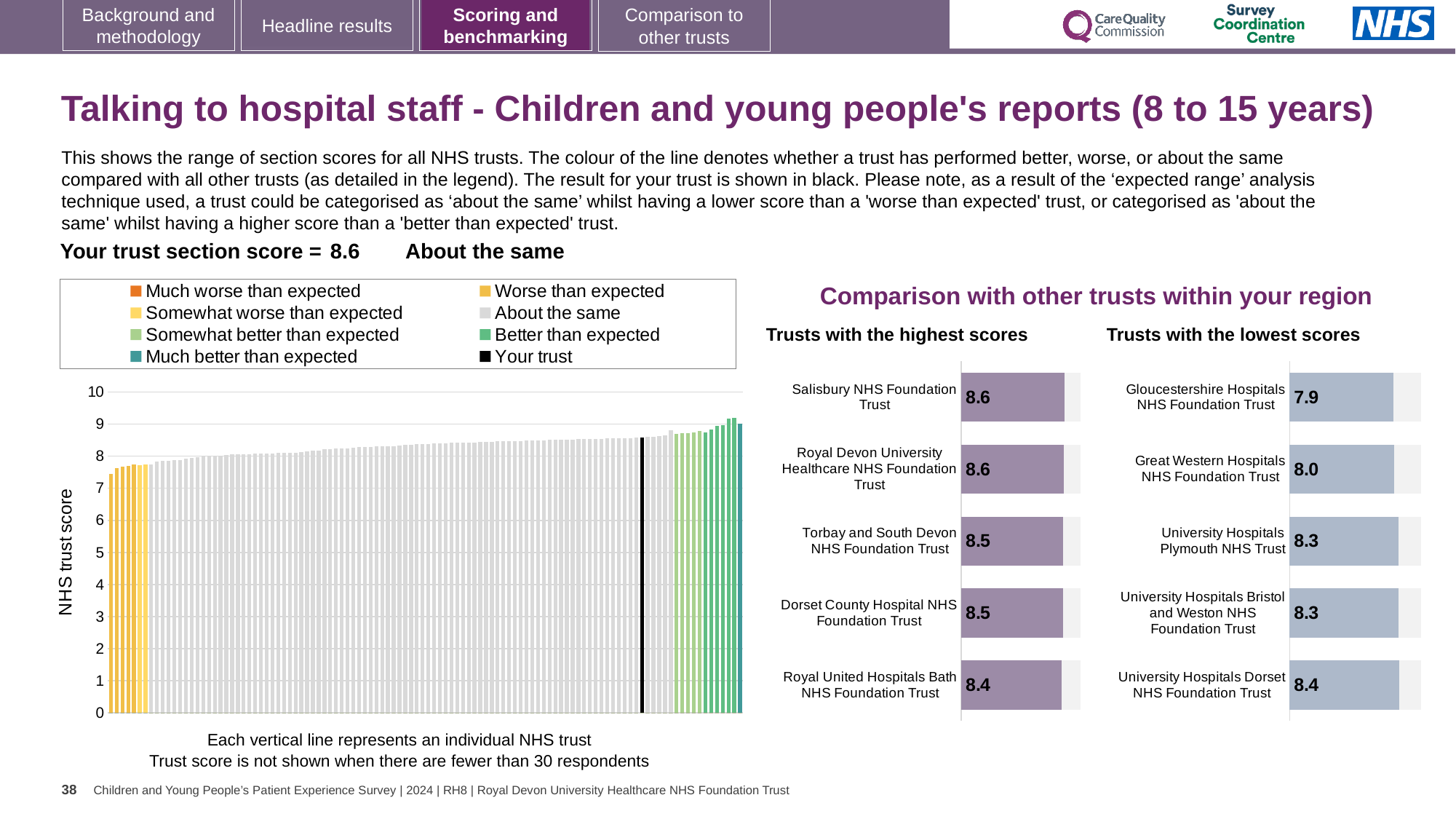
In the 'Trusts with the highest scores' chart, what is the value for Torbay and South Devon NHS Foundation Trust? 8.5 In the 'Trusts with the lowest scores' chart, which is larger: the value for Great Western Hospitals NHS Foundation Trust or University Hospitals Plymouth NHS Trust? University Hospitals Plymouth NHS Trust In the large chart on the left, do the trust scores rise or fall from left to right along the x axis? rise In the 'Trusts with the highest scores' chart, what is the difference between the values for Salisbury NHS Foundation Trust and Royal United Hospitals Bath NHS Foundation Trust? 0.2 In the 'Trusts with the highest scores' chart, what is the value for Royal United Hospitals Bath NHS Foundation Trust? 8.4 What kind of chart is the large chart on the left with the y axis labelled 'NHS trust score'? bar chart In the 'Trusts with the lowest scores' chart, which trust has the lowest value? Gloucestershire Hospitals NHS Foundation Trust In the large chart on the left, how many entries does the legend list? 8 In the large chart on the left, is the value of the black bar (your trust) greater or less than 8? greater In the 'Trusts with the lowest scores' chart, what is the value for Great Western Hospitals NHS Foundation Trust? 8.0 In the 'Trusts with the lowest scores' chart, what is the difference between the values for University Hospitals Dorset NHS Foundation Trust and Gloucestershire Hospitals NHS Foundation Trust? 0.5 In the 'Trusts with the highest scores' chart, how many trusts are shown? 5